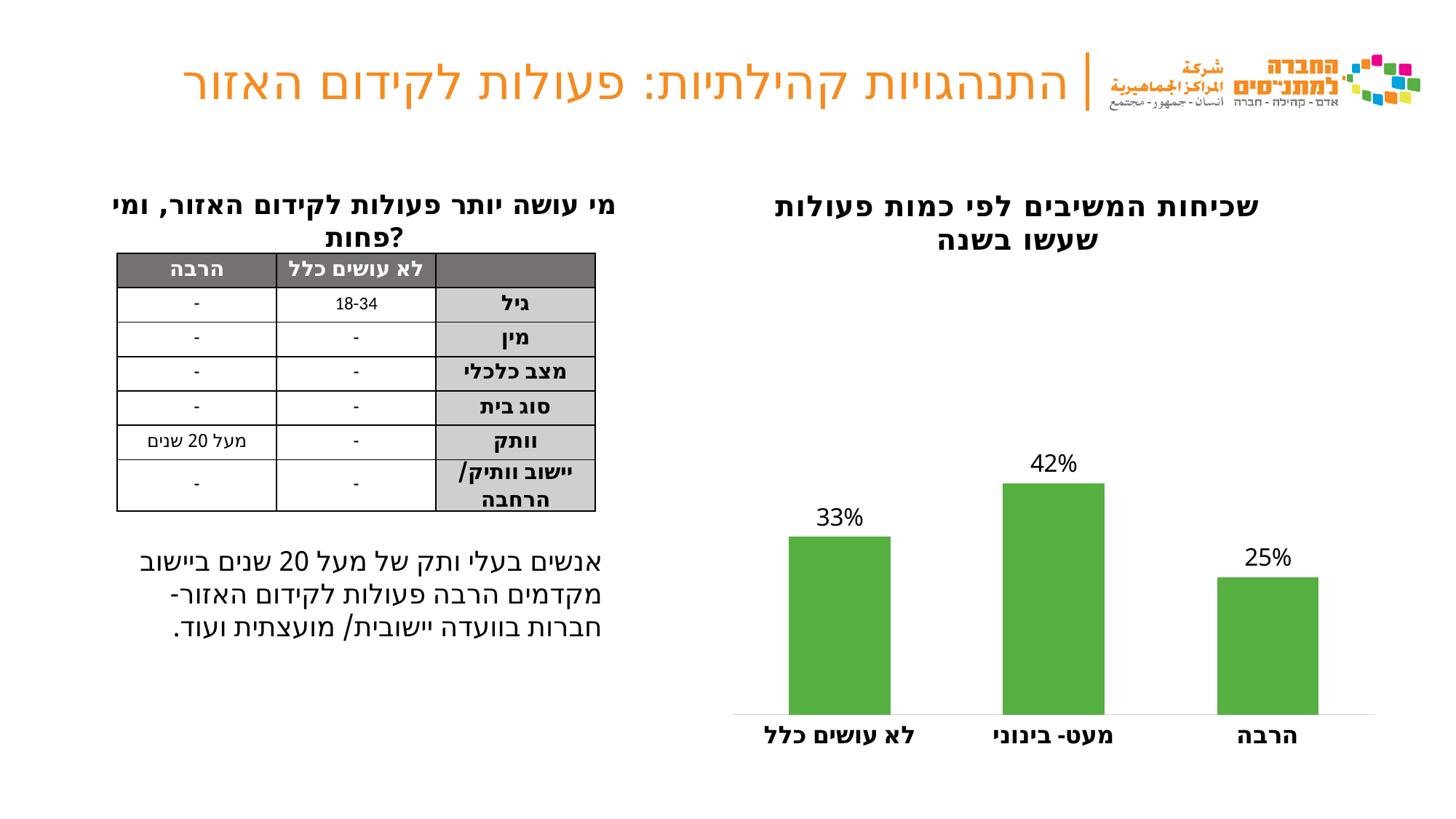
Which is larger, the value for "לא עושים כלל" or the value for "הרבה"? לא עושים כלל What is the title of the chart? שכיחות המשיבים לפי כמות פעולות שעשו בשנה What colour are the bars in the chart? Green What kind of chart is shown on the slide? Bar chart Which category has the highest share of respondents? מעט- בינוני What percentage of respondents are in the "מעט- בינוני" category? 42% What percentage of respondents are in the "הרבה" category? 25% What percentage of respondents are in the "לא עושים כלל" category? 33% How many categories are shown in the chart? 3 Which category has the lowest share of respondents? הרבה What is the difference between the "לא עושים כלל" and "הרבה" values? 8% What is the difference between the "מעט- בינוני" and "הרבה" values? 17%